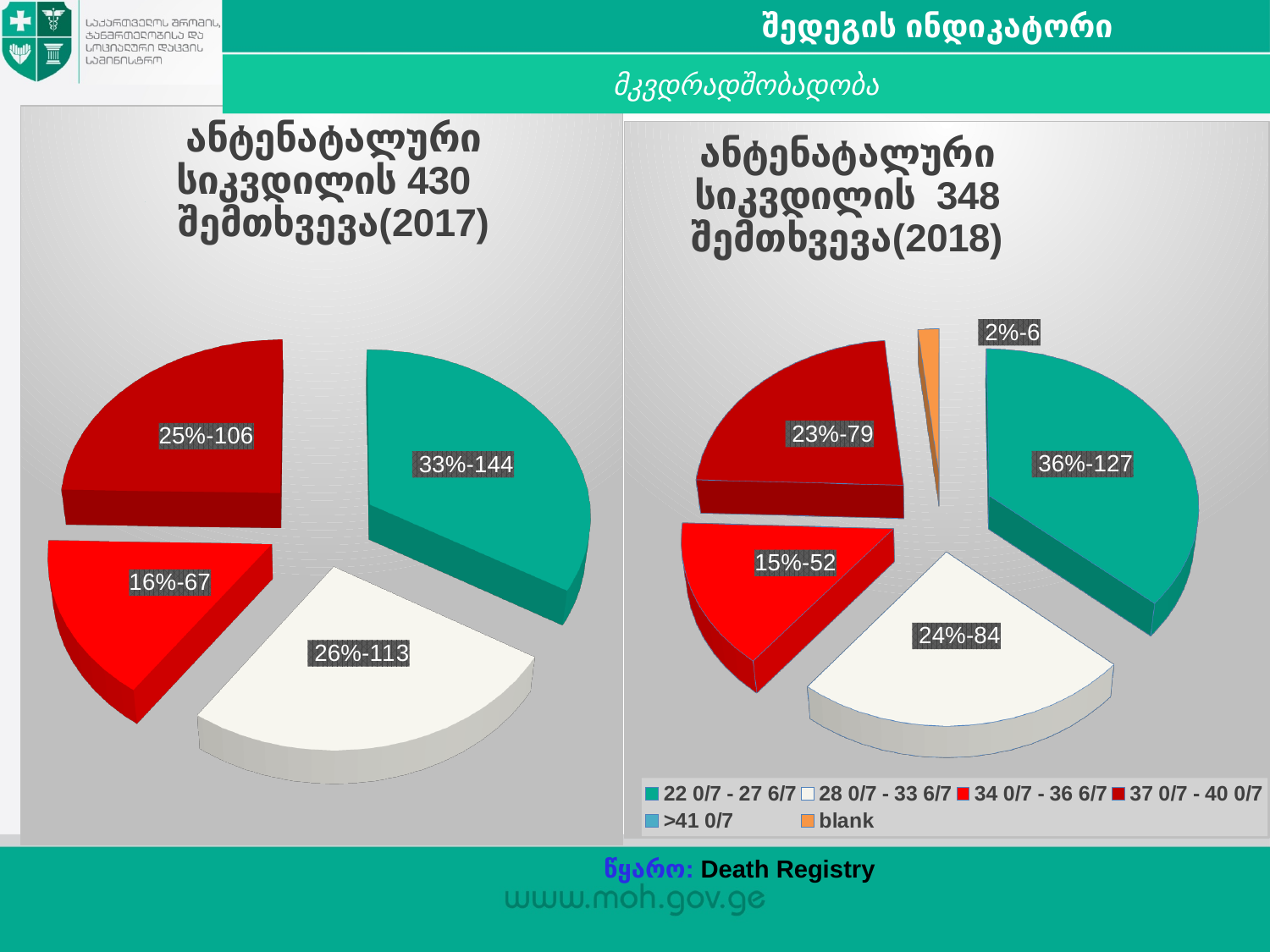
In the left chart (2017), which category has the largest slice? 22 0/7 - 27 6/7 In the left chart (2017), what is the label shown for the 22 0/7 - 27 6/7 slice? 33%-144 In the right chart (2018), what share of the pie does the 28 0/7 - 33 6/7 slice represent? 24% How many entries does the legend list? 6 What kind of chart is the left chart (2017)? pie chart In the left chart (2017), which category has the smallest slice? 34 0/7 - 36 6/7 In the right chart (2018), what is the label shown for the blank slice? 2%-6 How many slices does the right chart (2018) have? 5 How many slices does the left chart (2017) have? 4 In the right chart (2018), which category has the largest slice? 22 0/7 - 27 6/7 Which chart has the larger count for the 37 0/7 - 40 0/7 category, the left chart (2017) or the right chart (2018)? left chart (2017) In the right chart (2018), what is the difference in count between the 28 0/7 - 33 6/7 slice (84) and the 34 0/7 - 36 6/7 slice (52)? 32